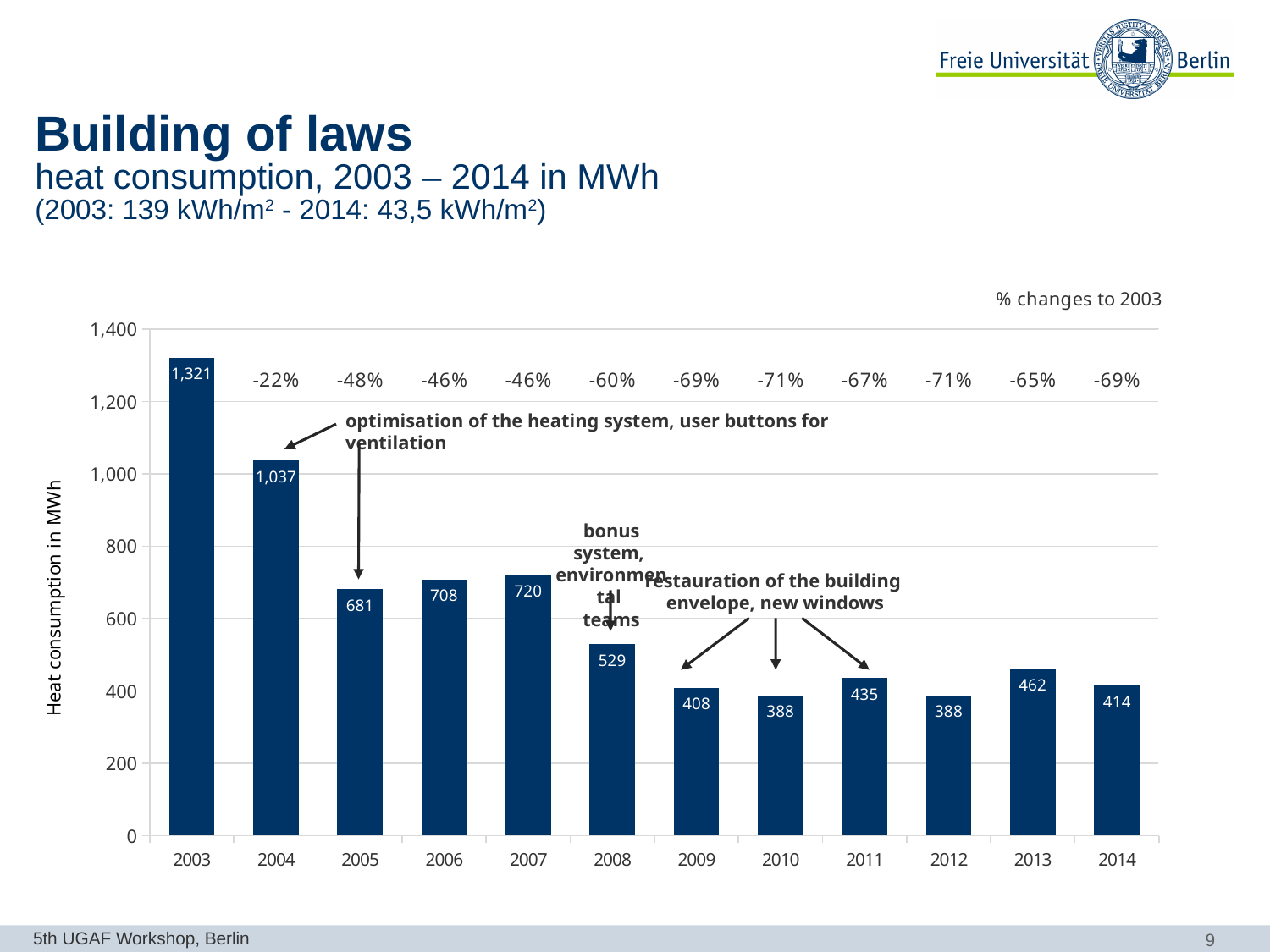
How many years are shown on the x axis? 12 Which year has the highest heat consumption? 2003 What was the heat consumption in 2014? 414 What was the heat consumption in 2008? 529 Which year had higher heat consumption, 2013 or 2011? 2013 Is the heat consumption for 2007 greater or less than 600? greater What kind of chart is shown on the slide? bar chart What was the heat consumption in 2003? 1,321 What is the lowest heat consumption value shown on the chart? 388 What is the difference in heat consumption between 2003 and 2004? 284 Does heat consumption generally rise or fall from 2003 to 2014? fall What percentage change to 2003 is shown above the 2010 bar? -71%